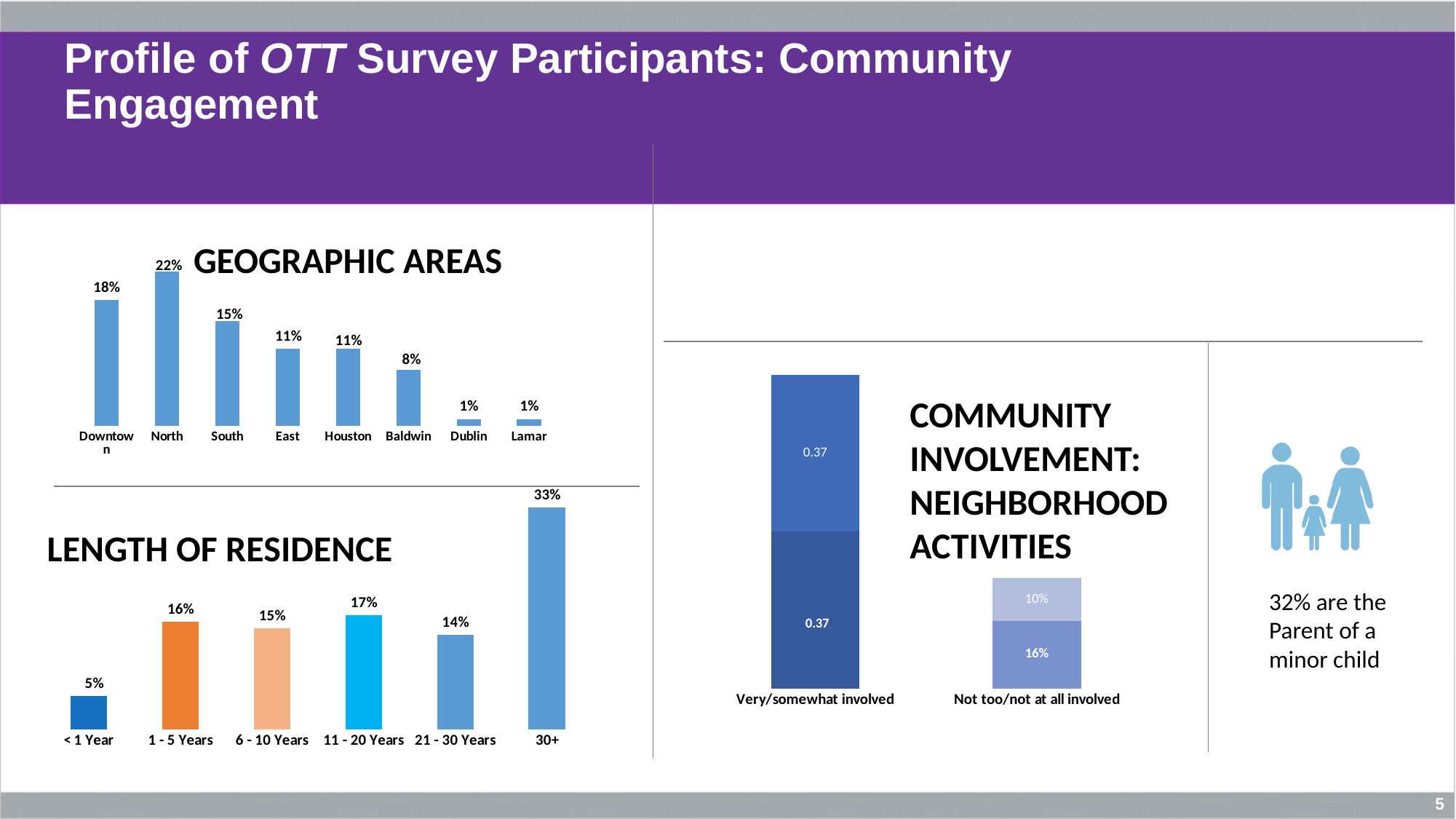
In the Community Involvement: Neighborhood Activities chart, what is the total of the Not too/not at all involved stacked bar? 26% In the Community Involvement: Neighborhood Activities chart, what is the value of the top segment of the Not too/not at all involved bar? 10% In the Geographic Areas chart, which area has the highest value? North How many categories are shown in the Length of Residence chart? 6 In the Geographic Areas chart, what is the difference between Downtown and Baldwin? 10% In the Length of Residence chart, which category has the lowest value? < 1 Year How many areas are shown in the Geographic Areas chart? 8 In the Geographic Areas chart, what is the value for North? 22% In the Length of Residence chart, what is the value for 30+? 33% In the Length of Residence chart, which is larger: 1 - 5 Years or 21 - 30 Years? 1 - 5 Years What kind of chart is the Length of Residence chart? Bar chart In the Community Involvement: Neighborhood Activities chart, what is the value of the bottom segment of the Very/somewhat involved bar? 0.37